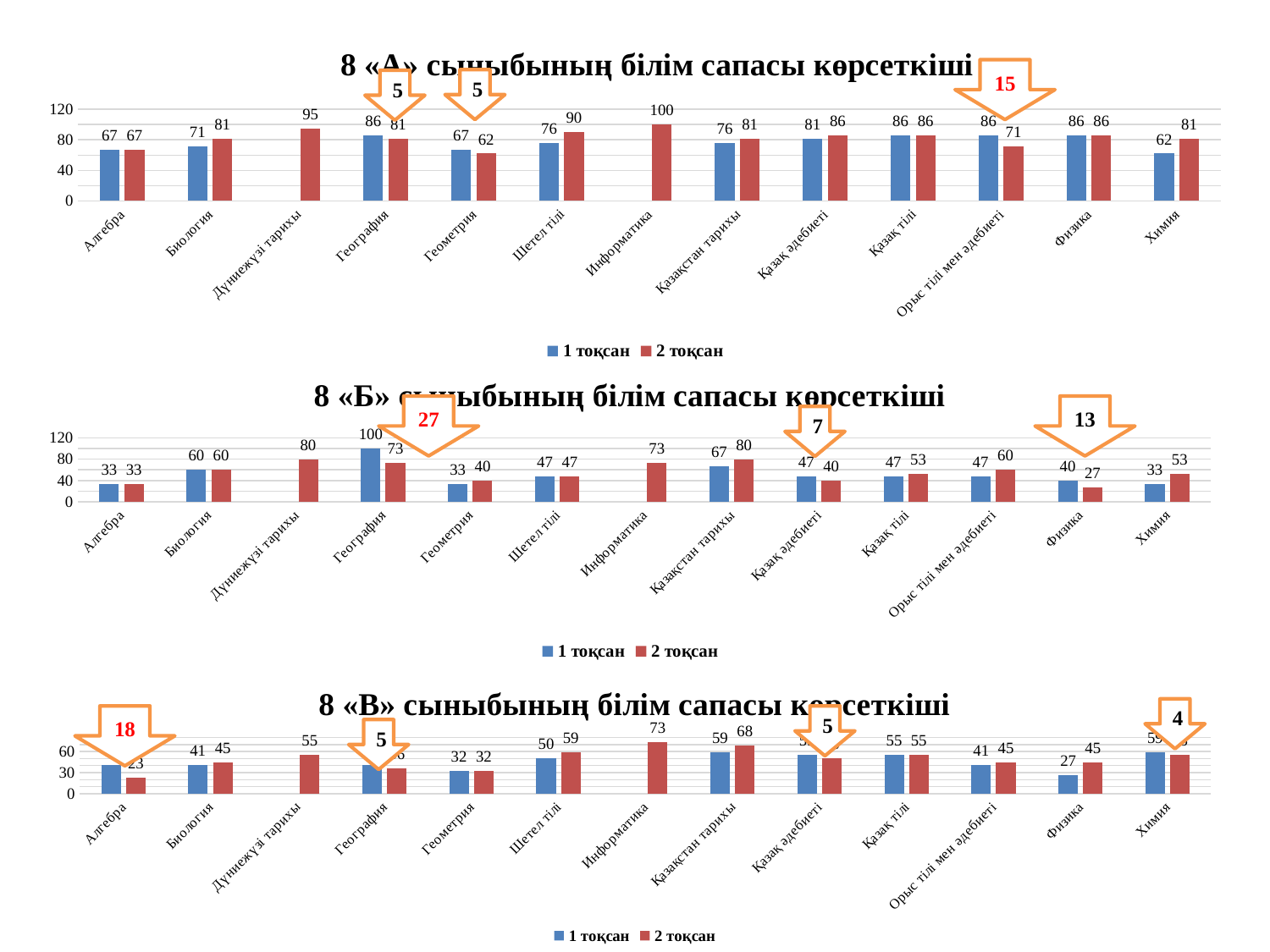
In the 8 «Б» chart, what is the difference between the 1 тоқсан and 2 тоқсан values for География? 27 What type of chart is the 8 «А» сыныбының білім сапасы көрсеткіші chart? Bar chart In the 8 «Б» chart, which category has the lowest 2 тоқсан value? Физика In the 8 «А» chart, which series has the larger value for Орыс тілі мен әдебиеті, 1 тоқсан or 2 тоқсан? 1 тоқсан In the 8 «Б» chart, which category has the highest 1 тоқсан value? География In the 8 «В» chart, which category has the highest 2 тоқсан value? Информатика In the 8 «А» chart, what is the value for 1 тоқсан for Химия? 62 How many series does the legend of the 8 «В» chart list? 2 In the 8 «А» chart, what is the value for 2 тоқсан for Информатика? 100 In the 8 «В» chart, what is the value for 2 тоқсан for Алгебра? 23 In the 8 «А» chart, what is the difference between the 2 тоқсан and 1 тоқсан values for Шетел тілі? 14 In the 8 «Б» chart, what is the value for 2 тоқсан for Физика? 27